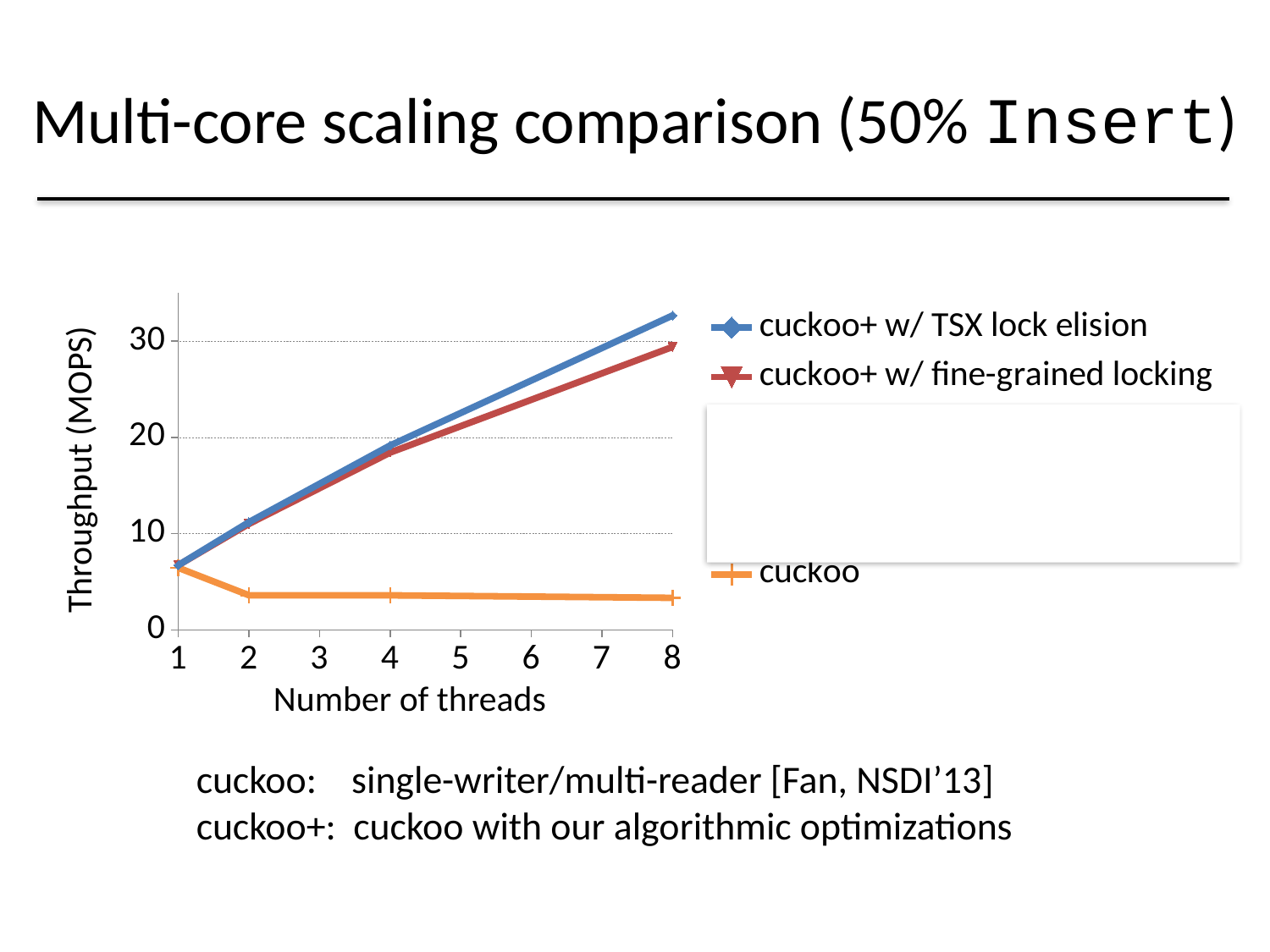
Is the throughput of cuckoo+ w/ TSX lock elision at 8 threads greater or less than 30? greater What kind of chart is shown on the slide? line chart How many series does the chart's legend list? 3 What is the label of the x axis? Number of threads Is the throughput of cuckoo at 8 threads greater or less than 10? less What is the label of the y axis? Throughput (MOPS) At 8 threads, which has higher throughput: cuckoo+ w/ TSX lock elision or cuckoo+ w/ fine-grained locking? cuckoo+ w/ TSX lock elision Does the throughput of cuckoo+ w/ TSX lock elision rise or fall as the number of threads increases? rise Which series has the lowest throughput at 8 threads? cuckoo Does the throughput of cuckoo rise or fall as the number of threads increases from 1 to 8? fall Which series has the highest throughput at 8 threads? cuckoo+ w/ TSX lock elision Is the throughput of cuckoo at 1 thread greater or less than 10? less